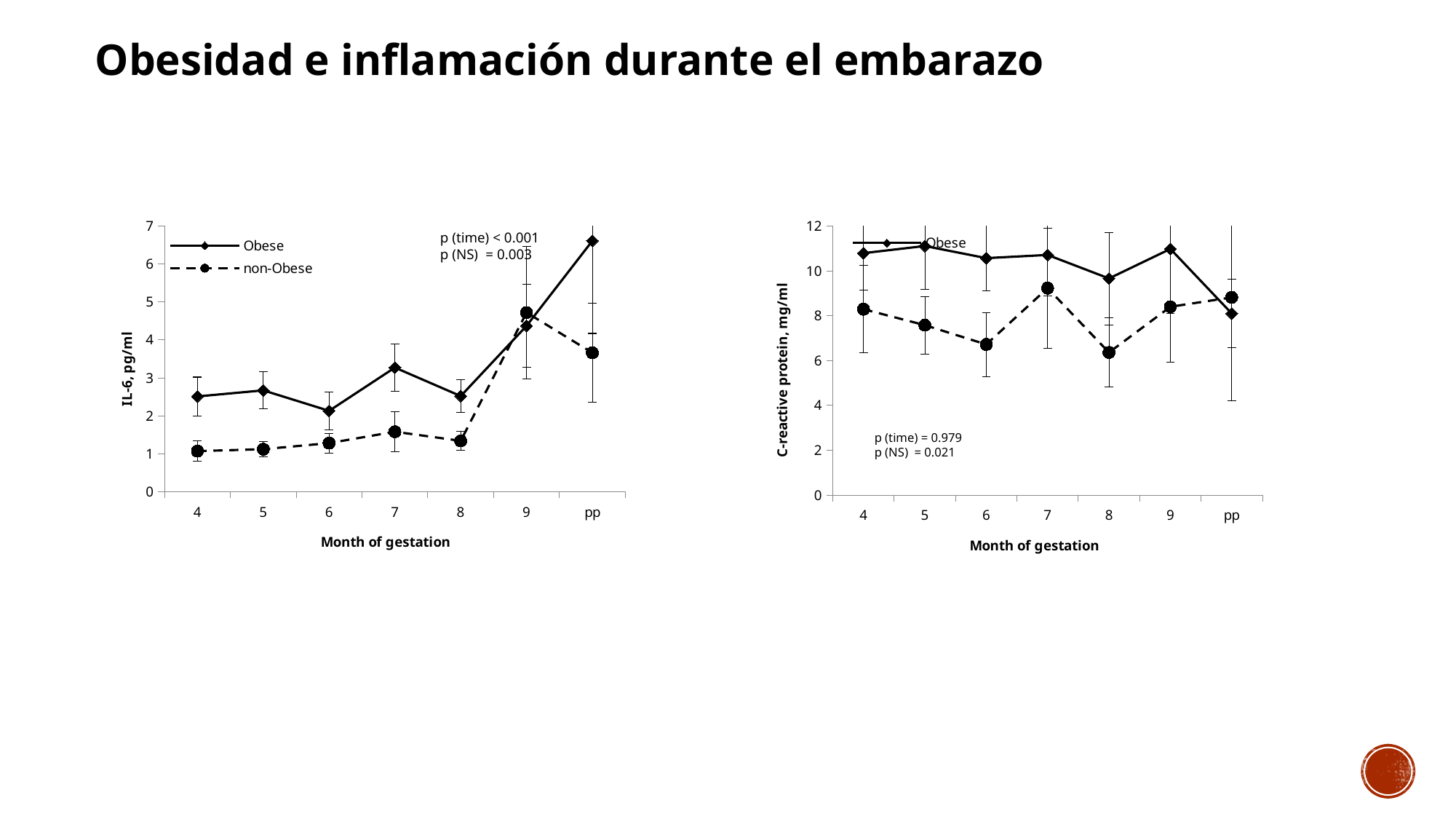
On the right chart (C-reactive protein, mg/ml), at which x-axis point is the Obese series lowest? pp On the left chart (IL-6, pg/ml), is the non-Obese value at month 4 greater or less than 2? less On the left chart (IL-6, pg/ml), which series has the larger value at pp, Obese or non-Obese? Obese On the left chart (IL-6, pg/ml), at which x-axis point is the Obese series highest? pp On the right chart (C-reactive protein, mg/ml), is the Obese value at month 4 greater or less than 10? greater On the left chart (IL-6, pg/ml), does the Obese series rise or fall from month 8 to pp? rise What is the x-axis title of the right chart (C-reactive protein, mg/ml)? Month of gestation On the left chart (IL-6, pg/ml), how many points are on the x axis? 7 What kind of chart is the left chart (IL-6, pg/ml)? line chart On the left chart (IL-6, pg/ml), is the Obese value at pp greater or less than 5? greater On the left chart (IL-6, pg/ml), at which month is the Obese series lowest? 6 On the left chart (IL-6, pg/ml), how many series does the legend list? 2